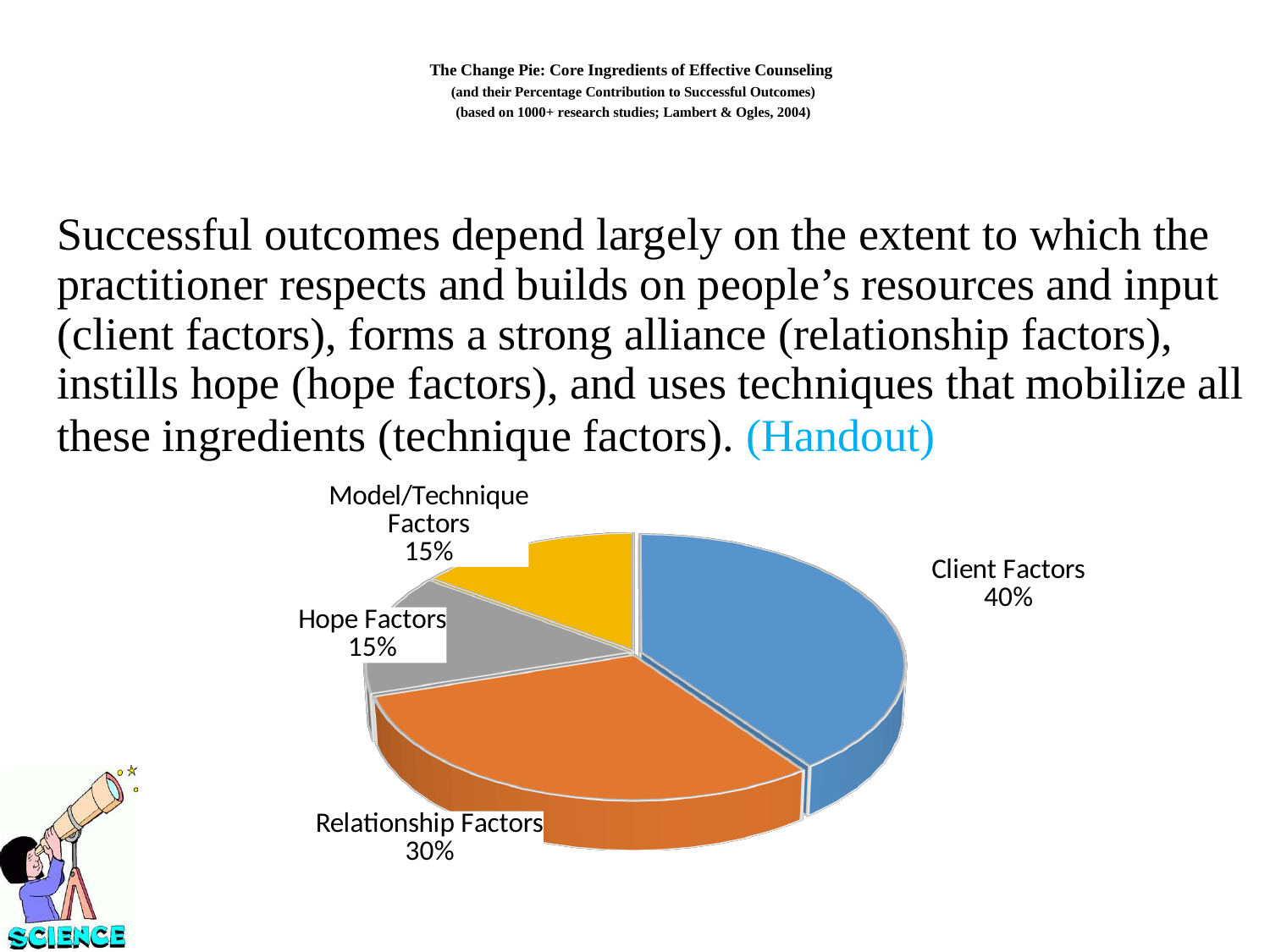
What colour is the Client Factors slice? Blue What type of chart is shown on the slide? Pie chart What is the combined share of Hope Factors and Model/Technique Factors? 30% What is the difference in percentage points between Client Factors and Relationship Factors? 10 What percentage is shown for Relationship Factors? 30% What is the title of the chart at the top of the slide? The Change Pie: Core Ingredients of Effective Counseling What percentage is shown for Model/Technique Factors? 15% Which is larger, Relationship Factors or Hope Factors? Relationship Factors What percentage is shown for Client Factors? 40% Which slice of the pie is the largest? Client Factors What percentage is shown for Hope Factors? 15% How many slices does the pie chart have? 4